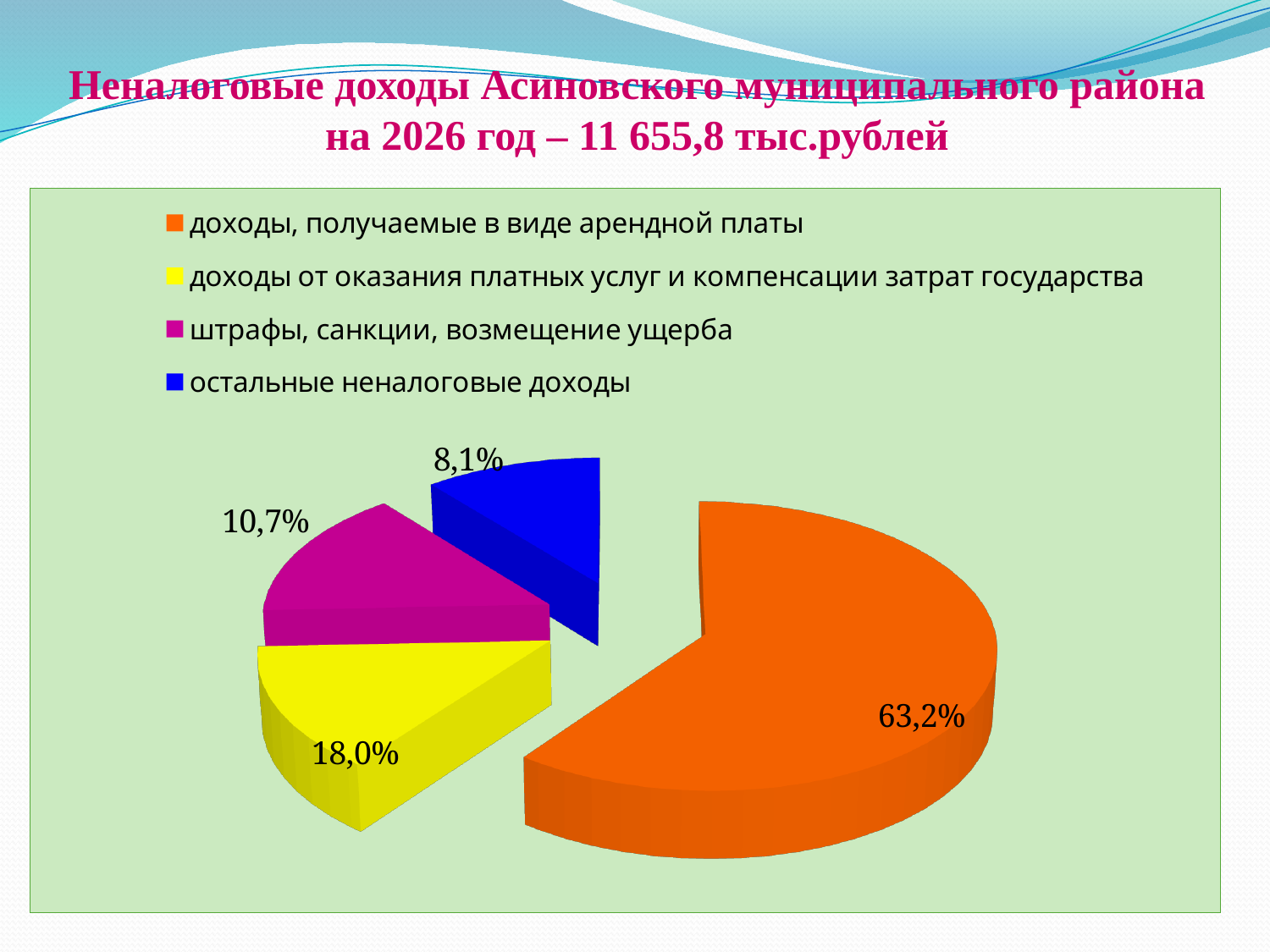
Какой тип диаграммы показан на слайде? круговая диаграмма Каким цветом на диаграмме обозначены доходы, получаемые в виде арендной платы? оранжевым Какую долю составляют штрафы, санкции, возмещение ущерба? 10,7% Какая общая сумма неналоговых доходов указана в заголовке слайда? 11 655,8 тыс.рублей Что больше: доля штрафов, санкций, возмещения ущерба или доля остальных неналоговых доходов? штрафы, санкции, возмещение ущерба Какую долю составляют остальные неналоговые доходы? 8,1% Какая категория имеет наибольшую долю на диаграмме? доходы, получаемые в виде арендной платы Сколько категорий показано на круговой диаграмме? 4 Какую долю составляют доходы, получаемые в виде арендной платы? 63,2% На сколько процентных пунктов доля доходов от оказания платных услуг и компенсации затрат государства больше доли штрафов, санкций, возмещения ущерба? 7,3 Какую долю составляют доходы от оказания платных услуг и компенсации затрат государства? 18,0% Какая категория имеет наименьшую долю на диаграмме? остальные неналоговые доходы